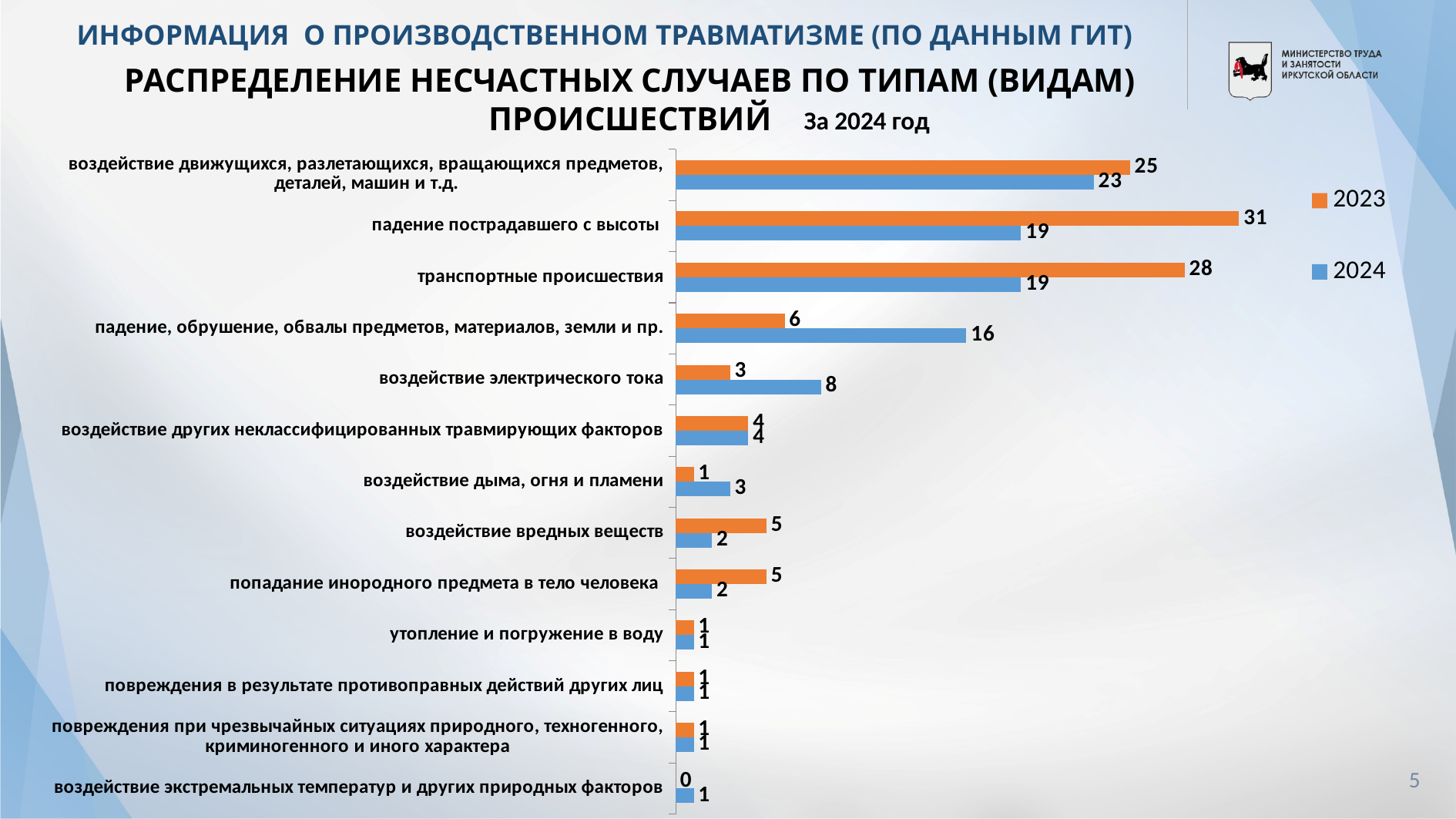
Which category has the highest 2023 value? падение пострадавшего с высоты What is the difference between the 2023 and 2024 values for 'транспортные происшествия'? 9 For 'воздействие электрического тока', which year has the larger value, 2023 or 2024? 2024 How many categories (types of incidents) are shown in the chart? 13 Which category has the highest 2024 value? воздействие движущихся, разлетающихся, вращающихся предметов, деталей, машин и т.д. Which colour represents the 2023 series in the legend? orange What is the 2023 value for 'падение пострадавшего с высоты'? 31 What is the 2024 value for 'транспортные происшествия'? 19 What type of chart is shown on the slide? bar chart Which category has the lowest 2023 value? воздействие экстремальных температур и других природных факторов How many series does the legend list? 2 What is the 2024 value for 'падение, обрушение, обвалы предметов, материалов, земли и пр.'? 16